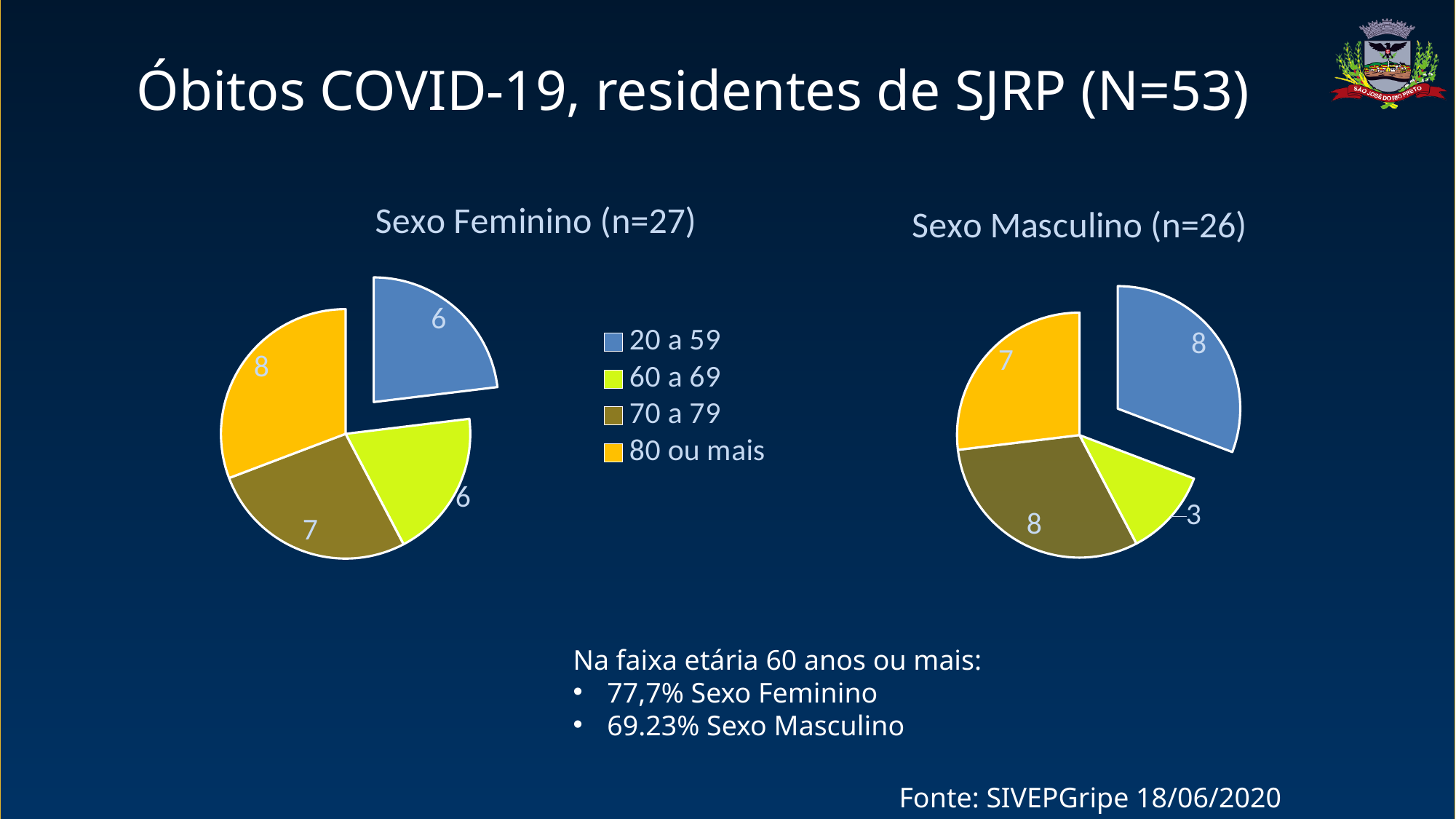
In the Sexo Feminino (n=27) chart, what is the value for the 80 ou mais slice? 8 In the Sexo Masculino (n=26) chart, what is the value for the 60 a 69 slice? 3 In the Sexo Feminino (n=27) chart, which age group has the largest slice? 80 ou mais Which colour represents the 80 ou mais age group in the legend? Orange In the Sexo Feminino (n=27) chart, what is the difference between the 80 ou mais slice and the 20 a 59 slice? 2 In the Sexo Masculino (n=26) chart, which age group has the smallest slice? 60 a 69 How many age-group categories does the legend list? 4 What kind of chart is the Sexo Masculino (n=26) chart? Pie chart Which is larger: the 60 a 69 slice in the Sexo Feminino chart or the 60 a 69 slice in the Sexo Masculino chart? Sexo Feminino In the Sexo Masculino (n=26) chart, what is the value for the 20 a 59 slice? 8 In the Sexo Feminino (n=27) chart, what is the value for the 70 a 79 slice? 7 In the Sexo Masculino (n=26) chart, what is the difference between the 20 a 59 slice and the 60 a 69 slice? 5